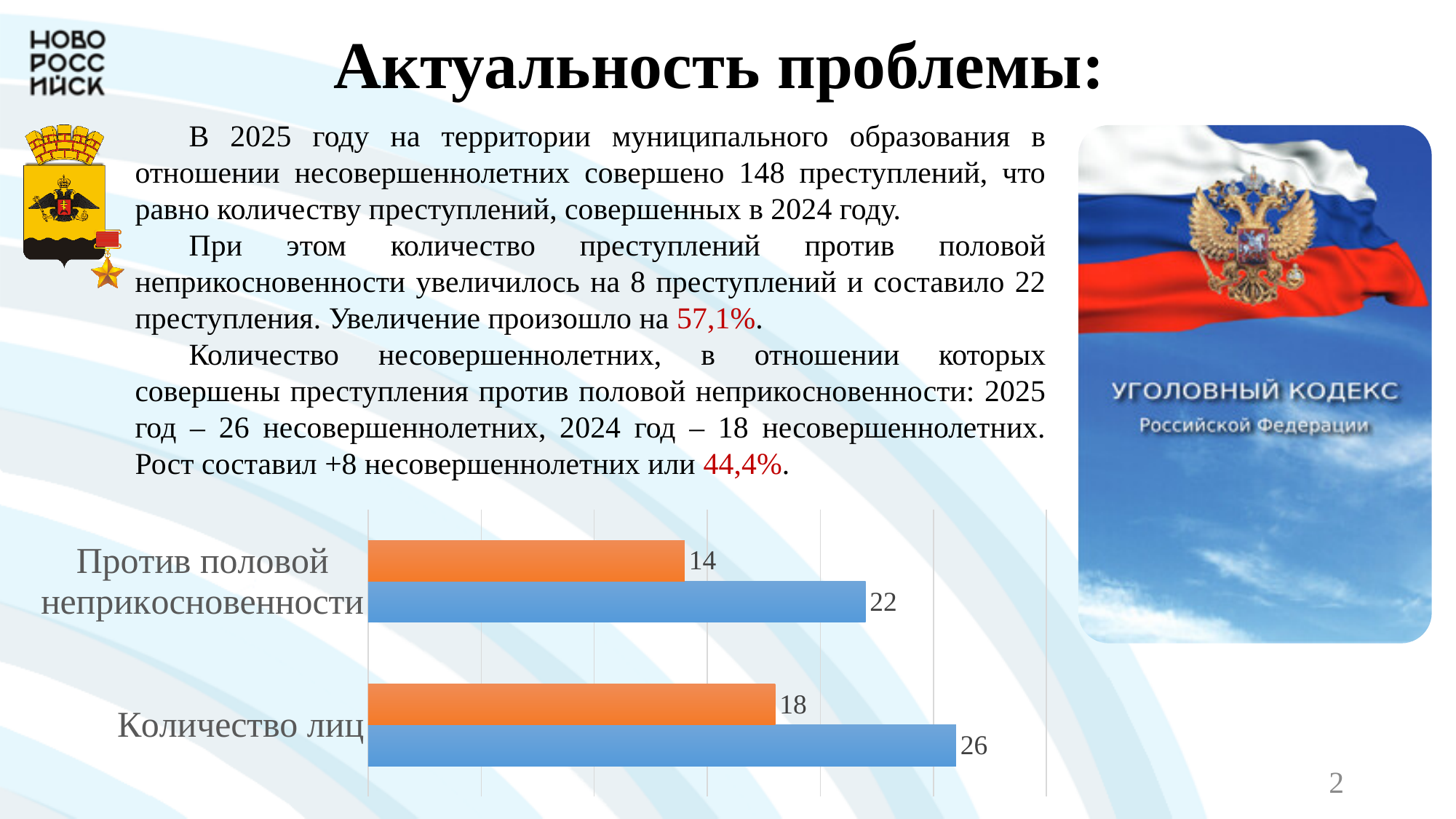
What type of chart is shown on the slide? bar chart Does the chart display a legend? No What is the value of the blue bar for "Против половой неприкосновенности"? 22 Which category has the lowest orange bar value? Против половой неприкосновенности Which category has the highest blue bar value? Количество лиц How many categories are shown on the chart? 2 Which bar is larger for "Против половой неприкосновенности", the blue one or the orange one? the blue one What is the difference between the blue and orange bars for "Количество лиц"? 8 What is the value of the orange bar for "Против половой неприкосновенности"? 14 What is the difference between the blue and orange bars for "Против половой неприкосновенности"? 8 What is the value of the orange bar for "Количество лиц"? 18 What is the value of the blue bar for "Количество лиц"? 26